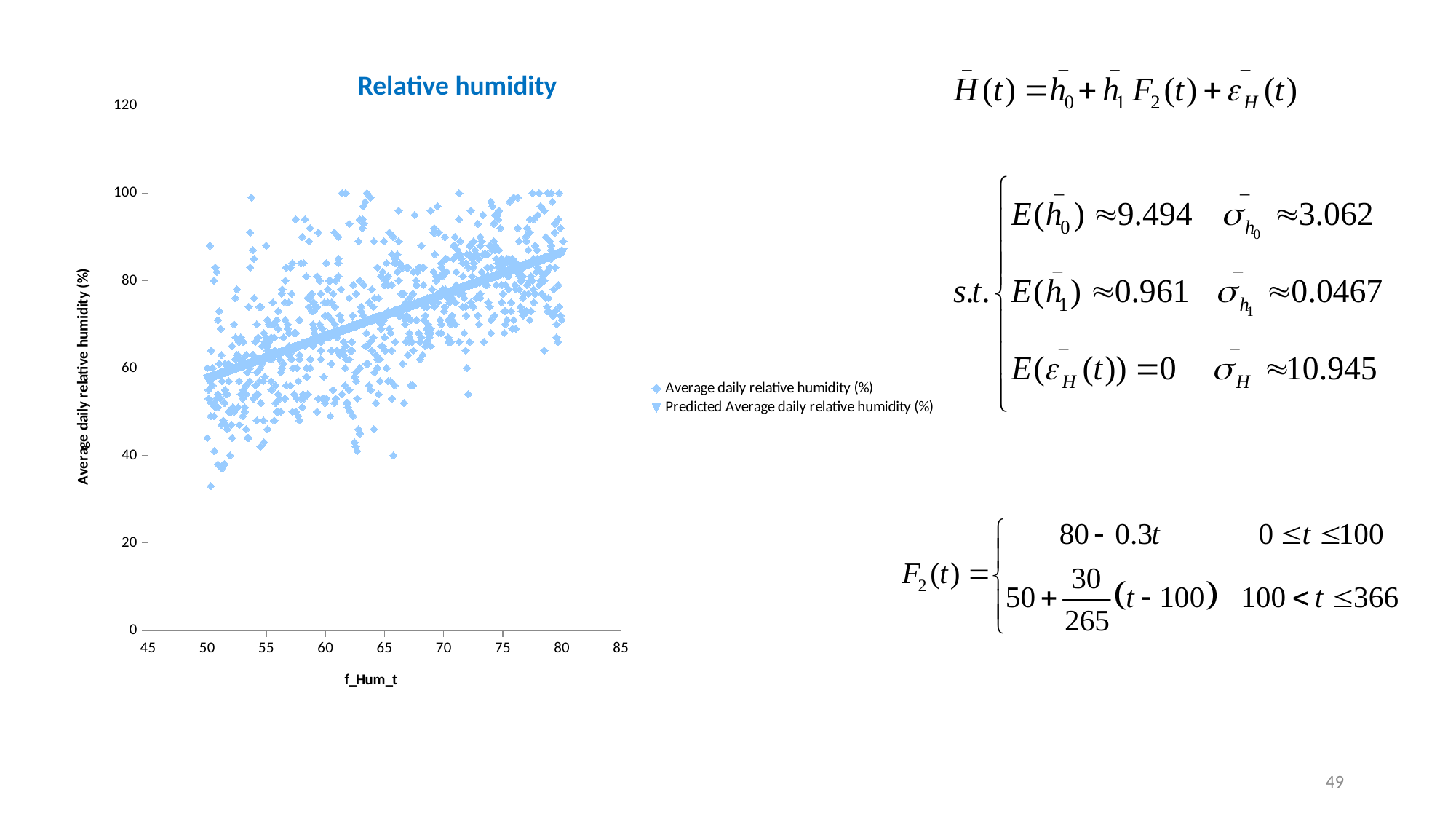
Do the predicted average daily relative humidity values rise or fall as f_Hum_t increases? Rise What is the first series listed in the chart's legend? Average daily relative humidity (%) How many series does the chart's legend list? 2 What is the highest value shown on the chart's vertical axis? 120 What is the title of the chart? Relative humidity Is the predicted average daily relative humidity at f_Hum_t = 50 greater or less than 60? less Is the predicted average daily relative humidity at f_Hum_t = 80 greater or less than 80? greater What kind of chart is shown on the slide? Scatter chart Is the lowest observed average daily relative humidity value greater or less than 40? less